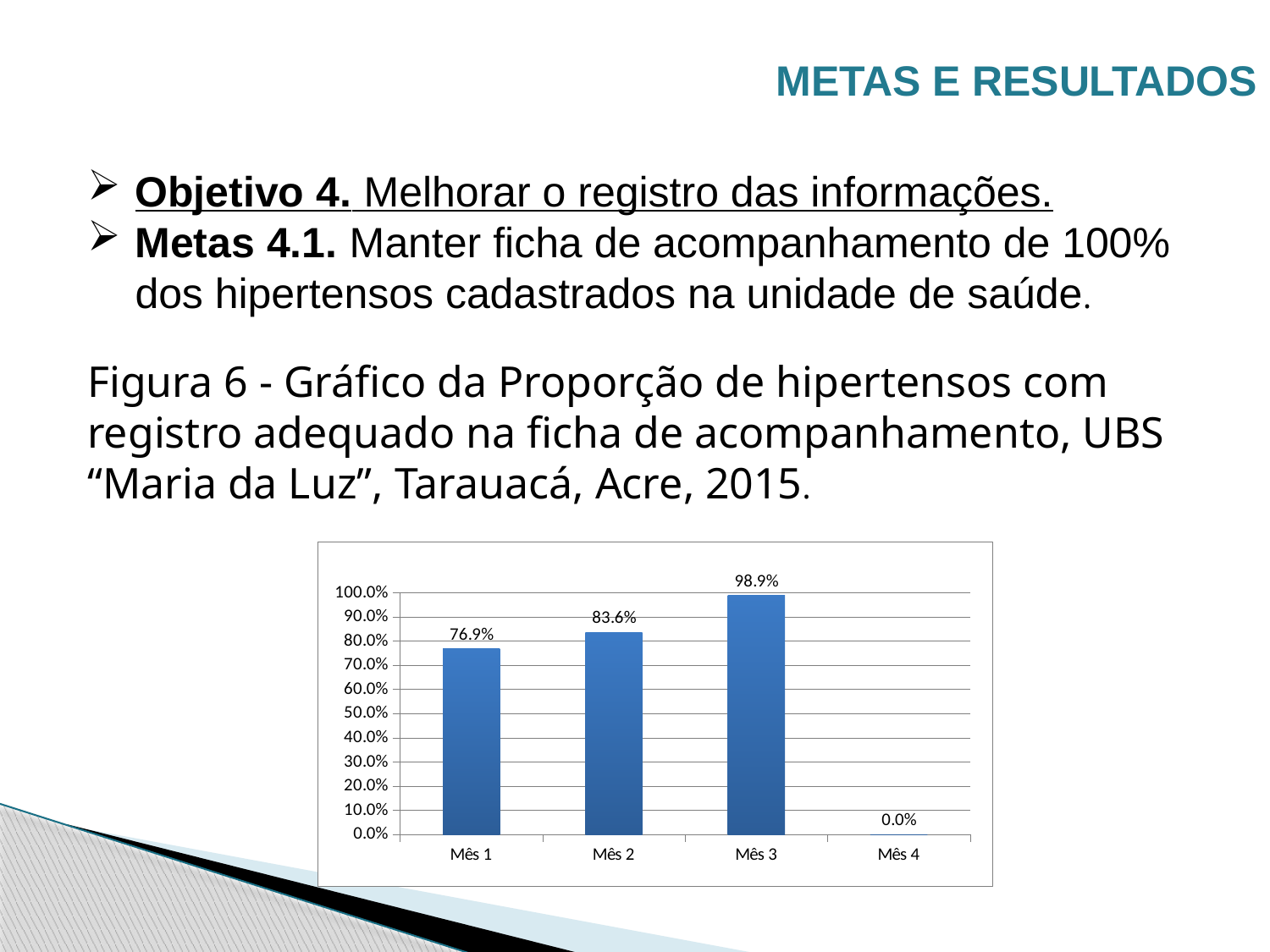
What kind of chart is shown on the slide? bar chart Which is larger, the value for Mês 2 or the value for Mês 3? Mês 3 How many months are shown on the x axis? 4 What is the value for Mês 2? 83.6% What is the difference between the values for Mês 2 and Mês 1? 6.7% What is the value for Mês 4? 0.0% What is the value for Mês 1? 76.9% What is the difference between the values for Mês 3 and Mês 1? 22.0% Which month has the lowest value? Mês 4 Is the value for Mês 1 greater or less than 70.0%? greater Which month has the highest value? Mês 3 What is the value for Mês 3? 98.9%